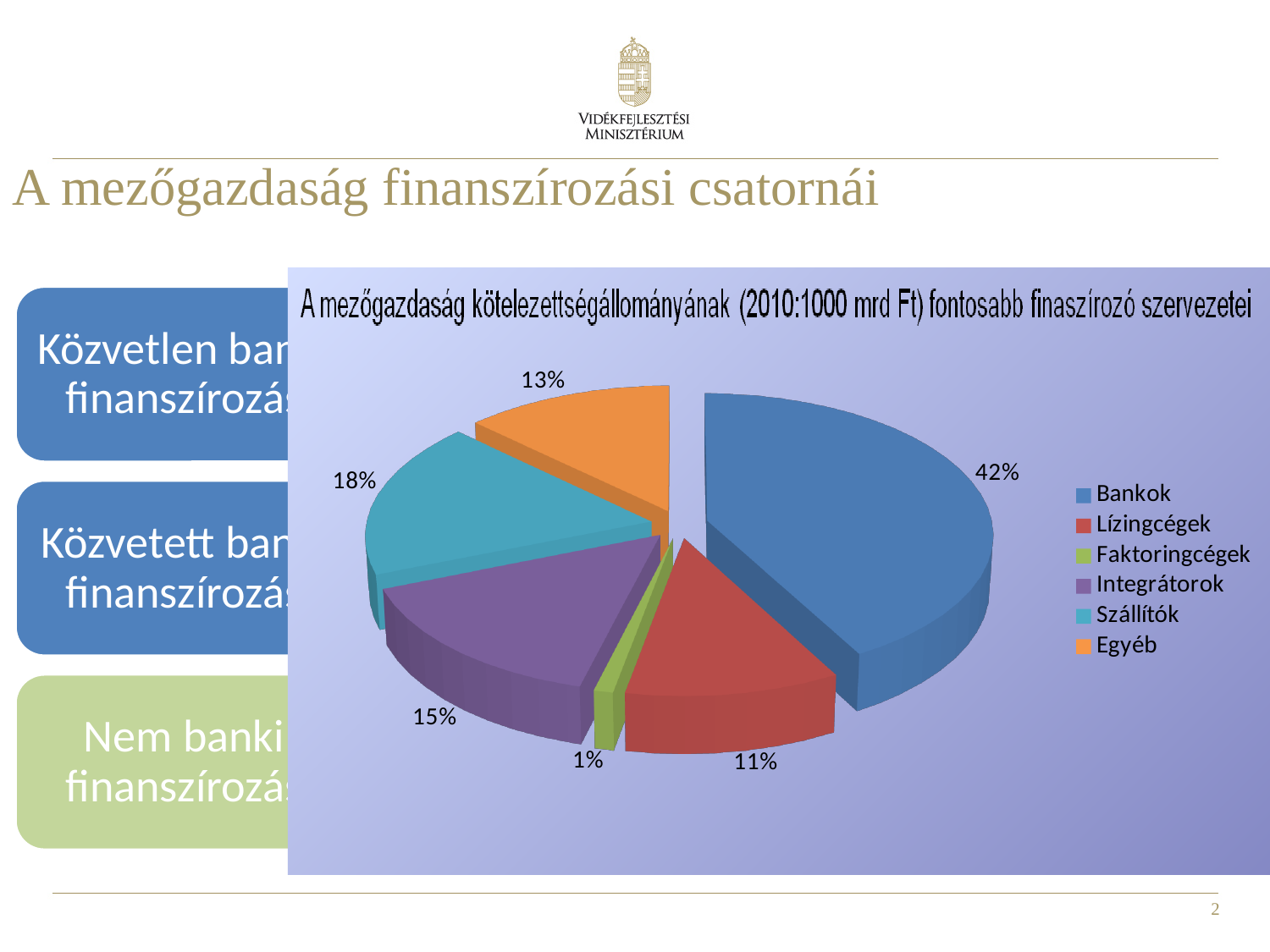
What share of the pie does Szállítók have? 18% Which slice is larger, Integrátorok or Egyéb? Integrátorok What share of the pie does Bankok have? 42% What share of the pie does Egyéb have? 13% What kind of chart is shown on the slide? pie chart Which category has the largest slice of the pie? Bankok Which category has the smallest slice of the pie? Faktoringcégek How many categories does the pie chart show? 6 What is the difference in percentage points between the Bankok slice and the Szállítók slice? 24